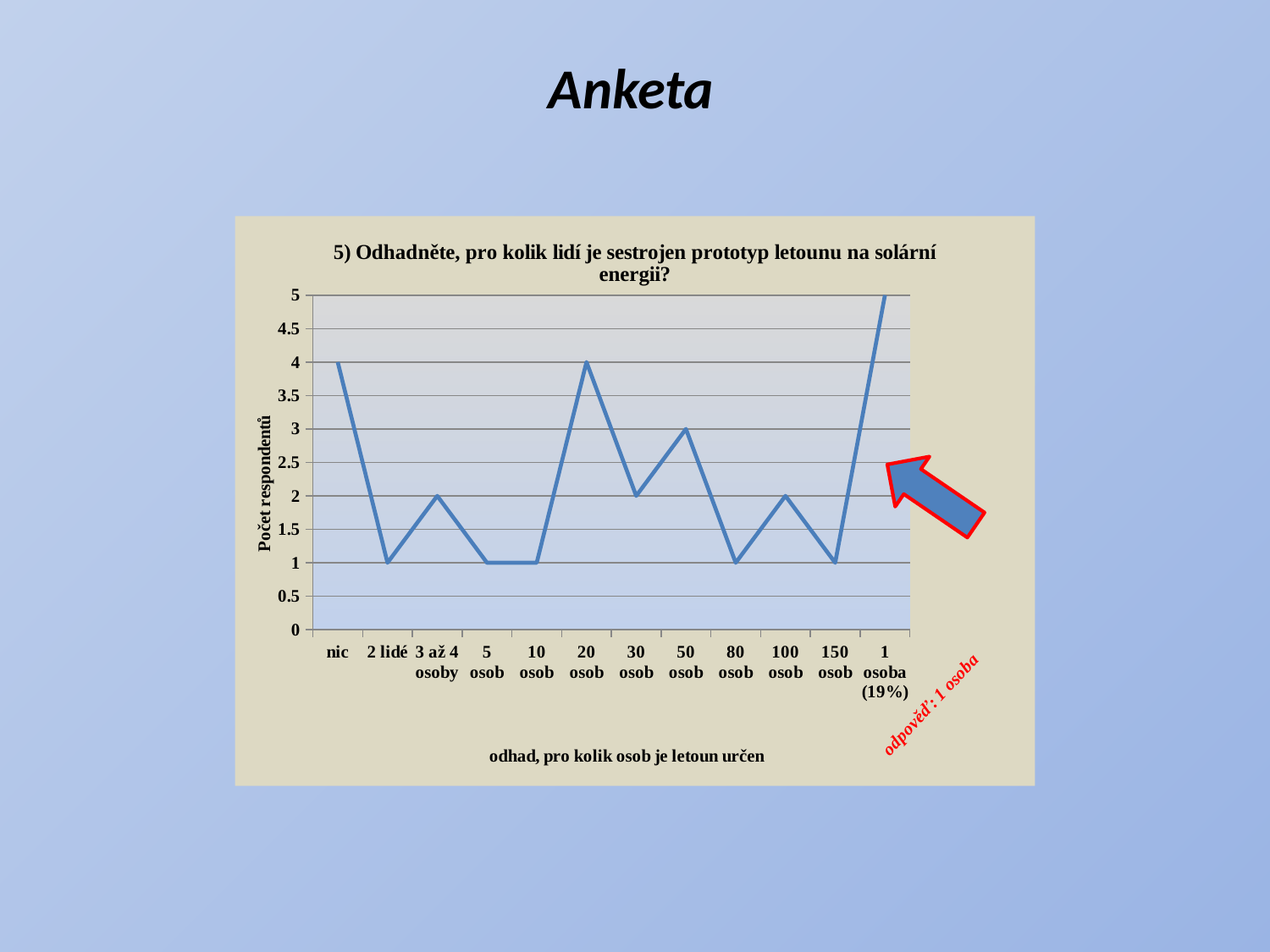
Which category has the highest value? 1 osoba (19%) How many categories are plotted along the x axis? 12 What is the label of the y axis? Počet respondentů What is the difference between the values for "1 osoba (19%)" and "150 osob"? 4 Which is larger, the value for "50 osob" or the value for "30 osob"? 50 osob What type of chart is shown on the slide? line chart What is the value for "1 osoba (19%)"? 5 What is the value for "20 osob"? 4 What is the label of the x axis? odhad, pro kolik osob je letoun určen What is the value for "50 osob"? 3 Is the value for "2 lidé" greater or less than 2? less What is the value for the category "nic"? 4